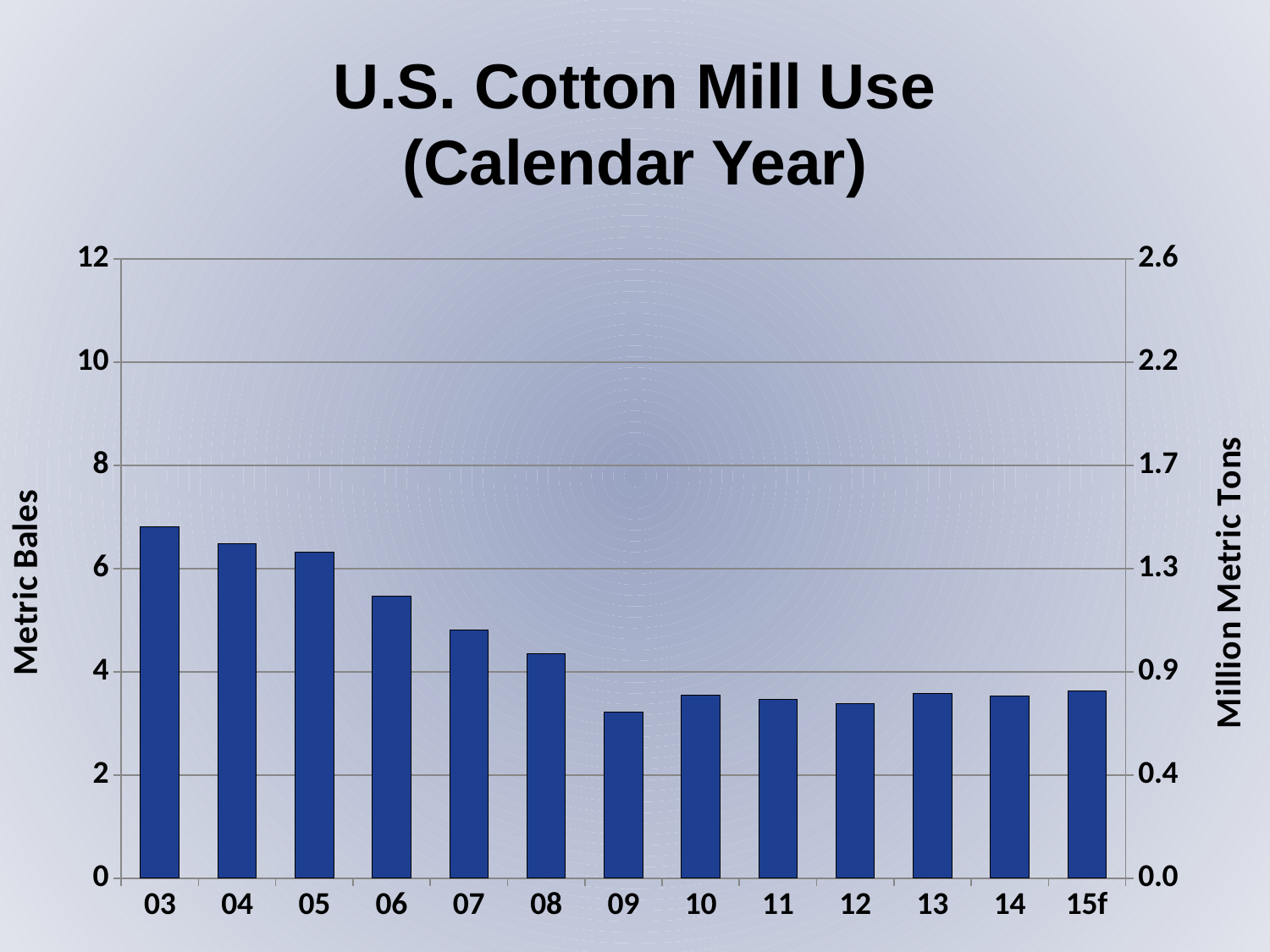
Which is larger, the value for 05 or the value for 07? 05 Is the value for 06 greater or less than 6 metric bales? less What is the label on the left vertical axis? Metric Bales Is the value for 09 greater or less than 4 metric bales? less Which year has the highest U.S. cotton mill use? 03 Is the value for 08 greater or less than 4 metric bales? greater How many years (categories) are plotted on the x axis? 13 What kind of chart is shown on the slide? bar chart What is the label on the right vertical axis? Million Metric Tons Do the values generally rise or fall from 03 to 09? fall